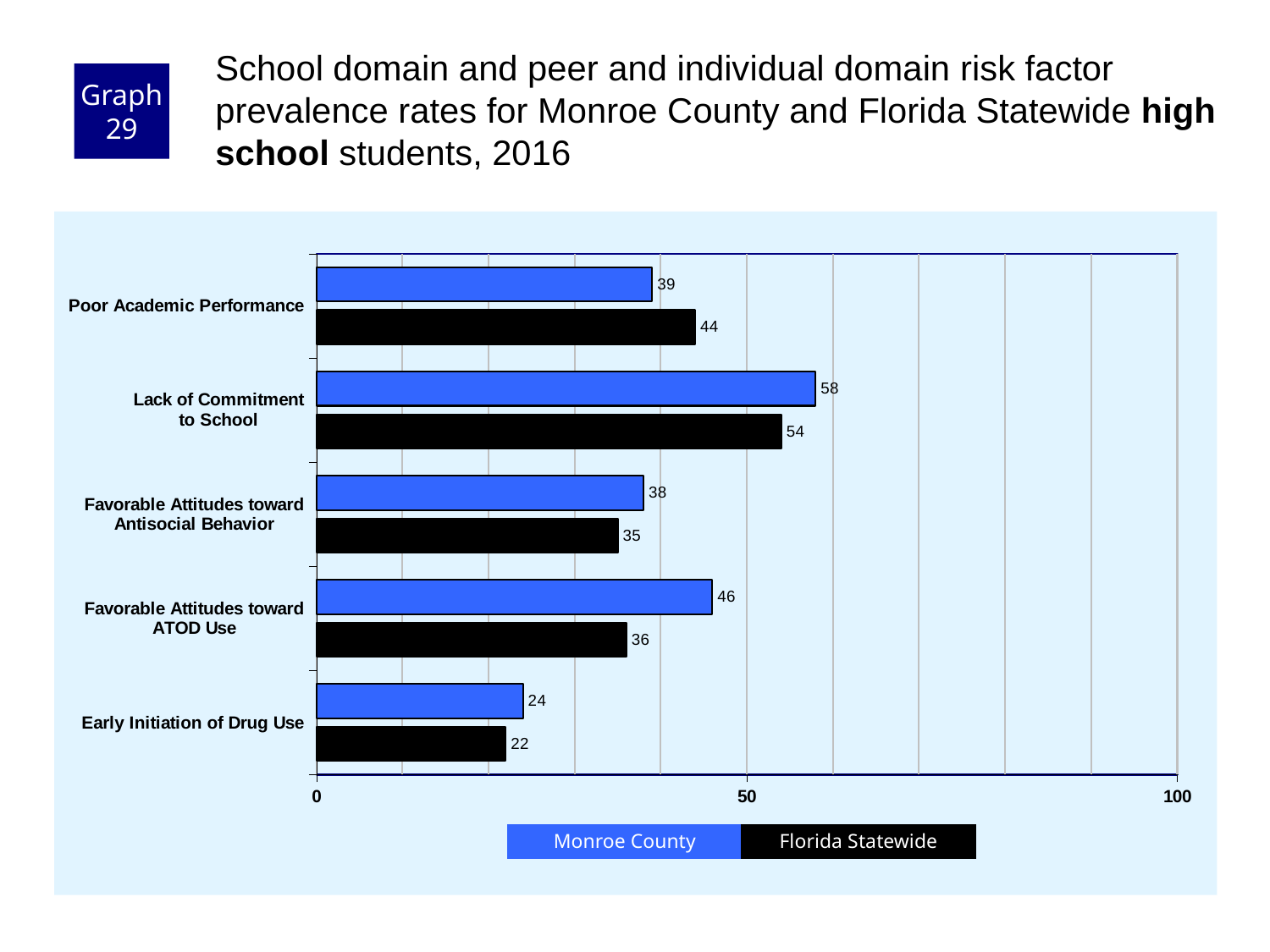
Which colour represents Florida Statewide in the chart? black How many risk factor categories are shown on the chart? 5 What is the Florida Statewide value for Poor Academic Performance? 44 What is the Monroe County value for Lack of Commitment to School? 58 Is the Monroe County value for Lack of Commitment to School greater or less than 50? greater Which risk factor has the highest Monroe County value? Lack of Commitment to School What is the difference between the Monroe County and Florida Statewide values for Favorable Attitudes toward ATOD Use? 10 For Poor Academic Performance, which is larger: Monroe County or Florida Statewide? Florida Statewide What kind of chart is shown on the slide? bar chart Which risk factor has the lowest Florida Statewide value? Early Initiation of Drug Use How many series does the legend list? 2 What is the Monroe County value for Early Initiation of Drug Use? 24